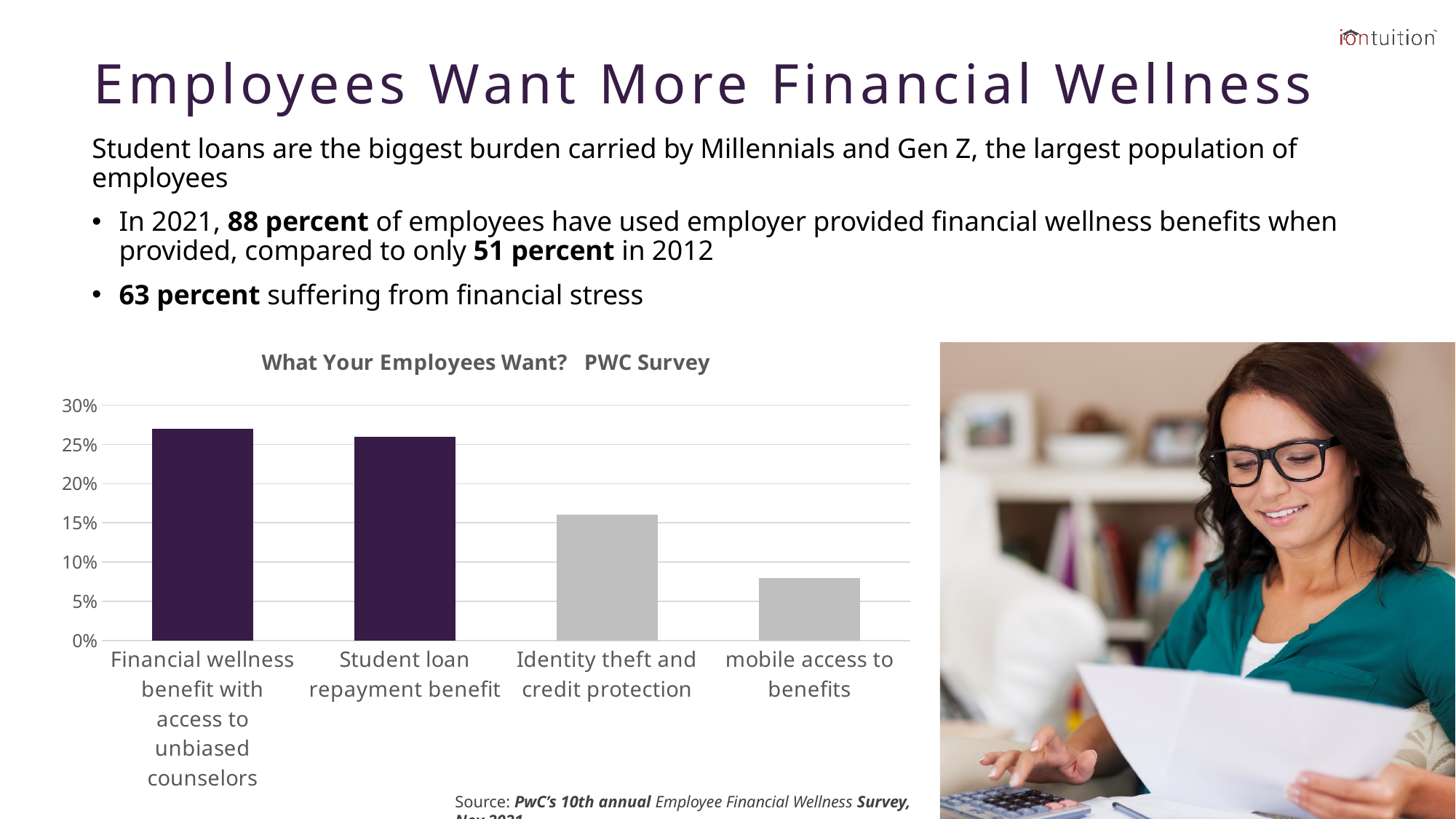
Do the values rise or fall moving from left to right across the categories? Fall Is the value for Financial wellness benefit with access to unbiased counselors greater or less than 30%? less Which is larger: the value for Student loan repayment benefit or the value for Identity theft and credit protection? Student loan repayment benefit Is the value for Identity theft and credit protection greater or less than 20%? less How many categories are shown in the chart? 4 Which is larger: the value for Identity theft and credit protection or the value for mobile access to benefits? Identity theft and credit protection Is the value for mobile access to benefits greater or less than 5%? greater What kind of chart is shown on the slide? Bar chart Which category has the lowest value in the chart? mobile access to benefits What is the title of the chart? What Your Employees Want? PWC Survey